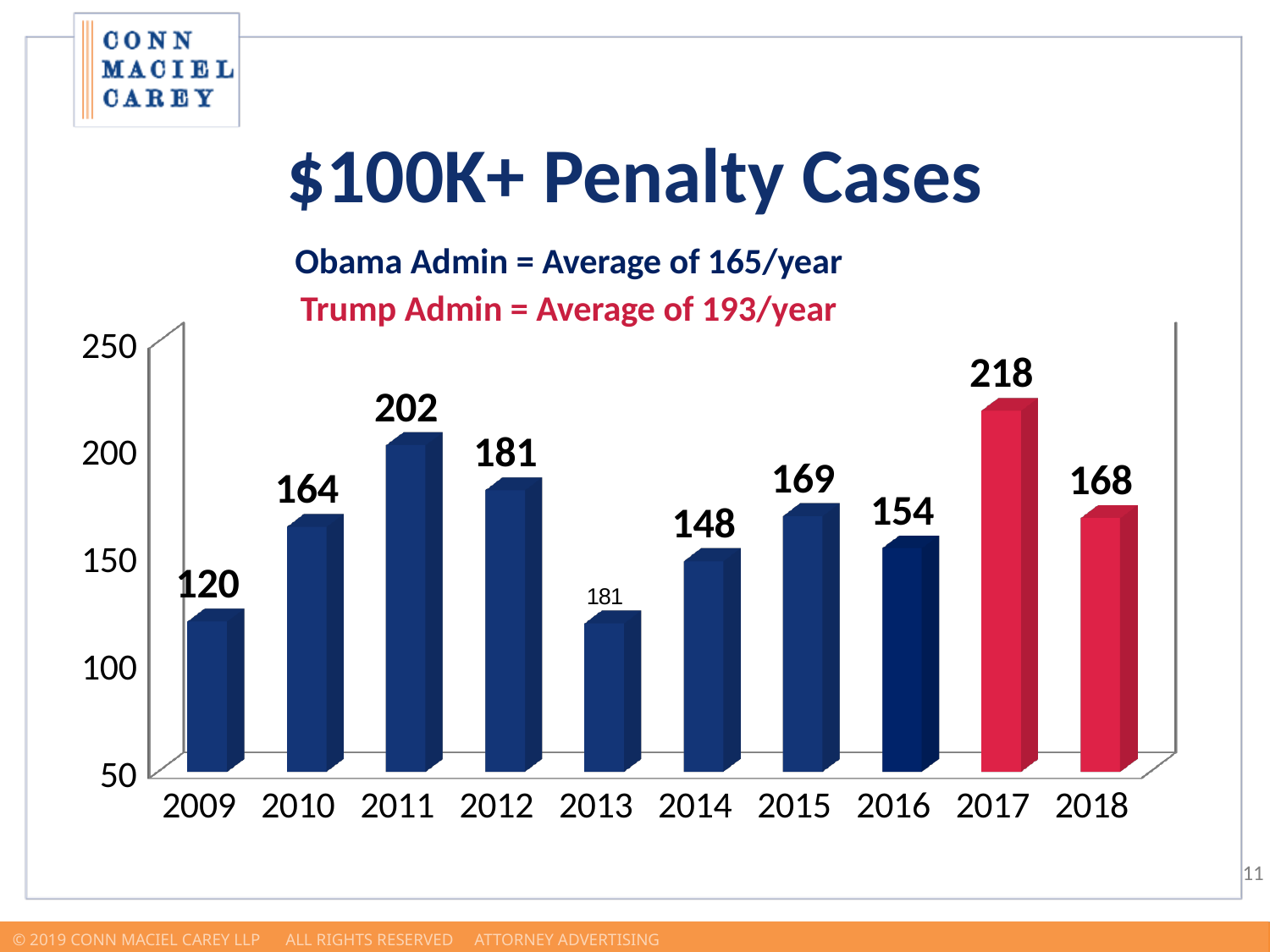
Which year has the highest number of $100K+ penalty cases? 2017 What is the difference between the values for 2017 and 2018? 50 What is the title of the chart? $100K+ Penalty Cases What is the value for 2017? 218 What is the difference between the values for 2011 and 2010? 38 What is the value for 2011? 202 Which is larger, the value for 2010 or the value for 2015? 2015 What is the value for 2009? 120 How many years are shown on the x axis? 10 Is the value for 2012 greater or less than 200? less What kind of chart is shown on the slide? bar chart What is the value for 2016? 154